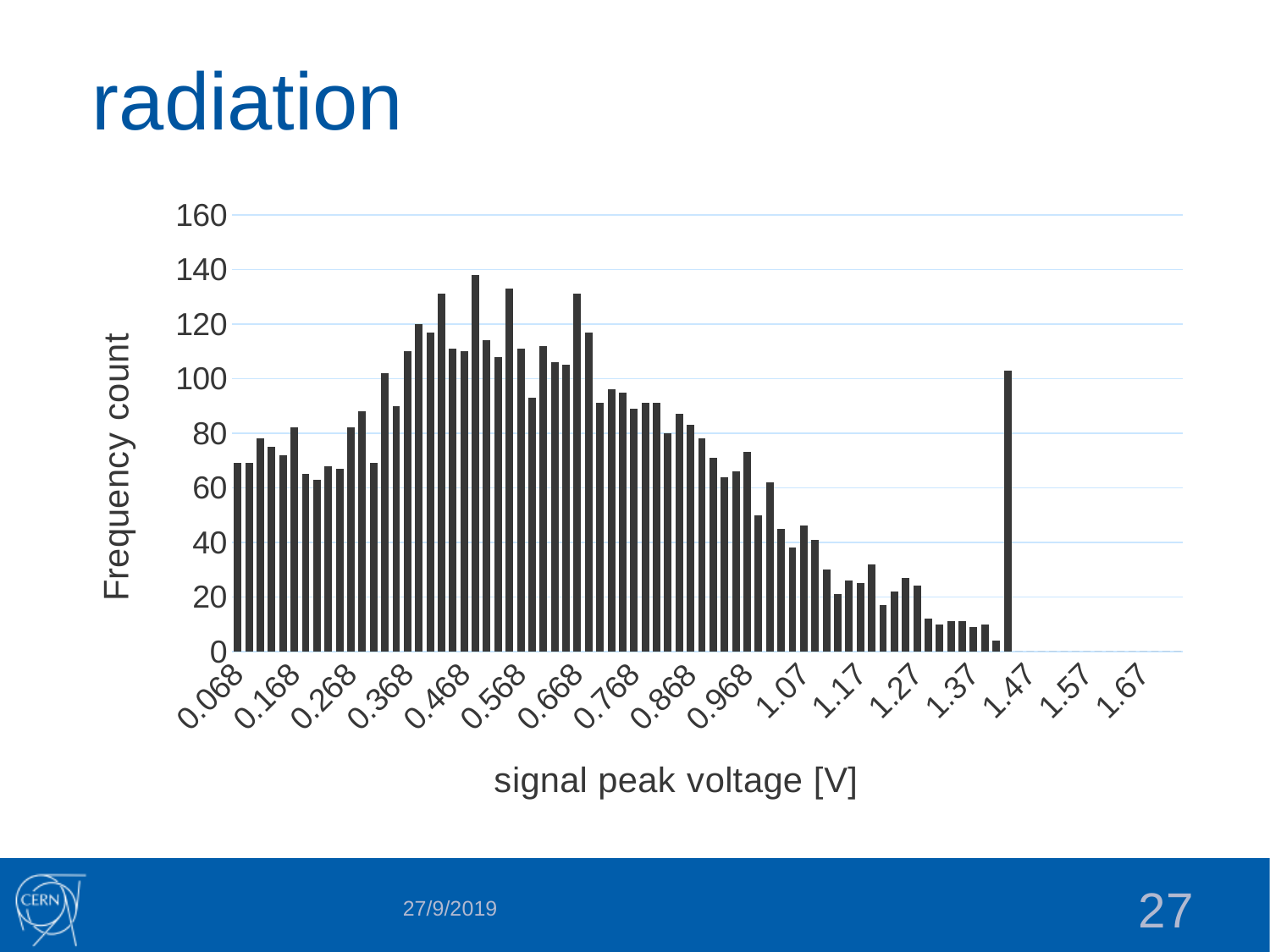
What is the title of the x axis of the chart? signal peak voltage [V] Is the frequency count for the first bar at 0.068 V greater or less than 60? greater Is the tallest bar in the chart greater or less than 120? greater Do the frequency counts generally rise or fall along the x axis between about 0.7 V and 1.4 V? fall What is the highest value shown on the y axis? 160 Is the frequency count for the first bar at 0.068 V greater or less than 80? less Is the first bar at 0.068 V taller or shorter than the tallest bar near 0.468 V? shorter How many tick labels are shown on the x axis? 17 What kind of chart is shown on the slide? bar chart What is the title of the y axis of the chart? Frequency count